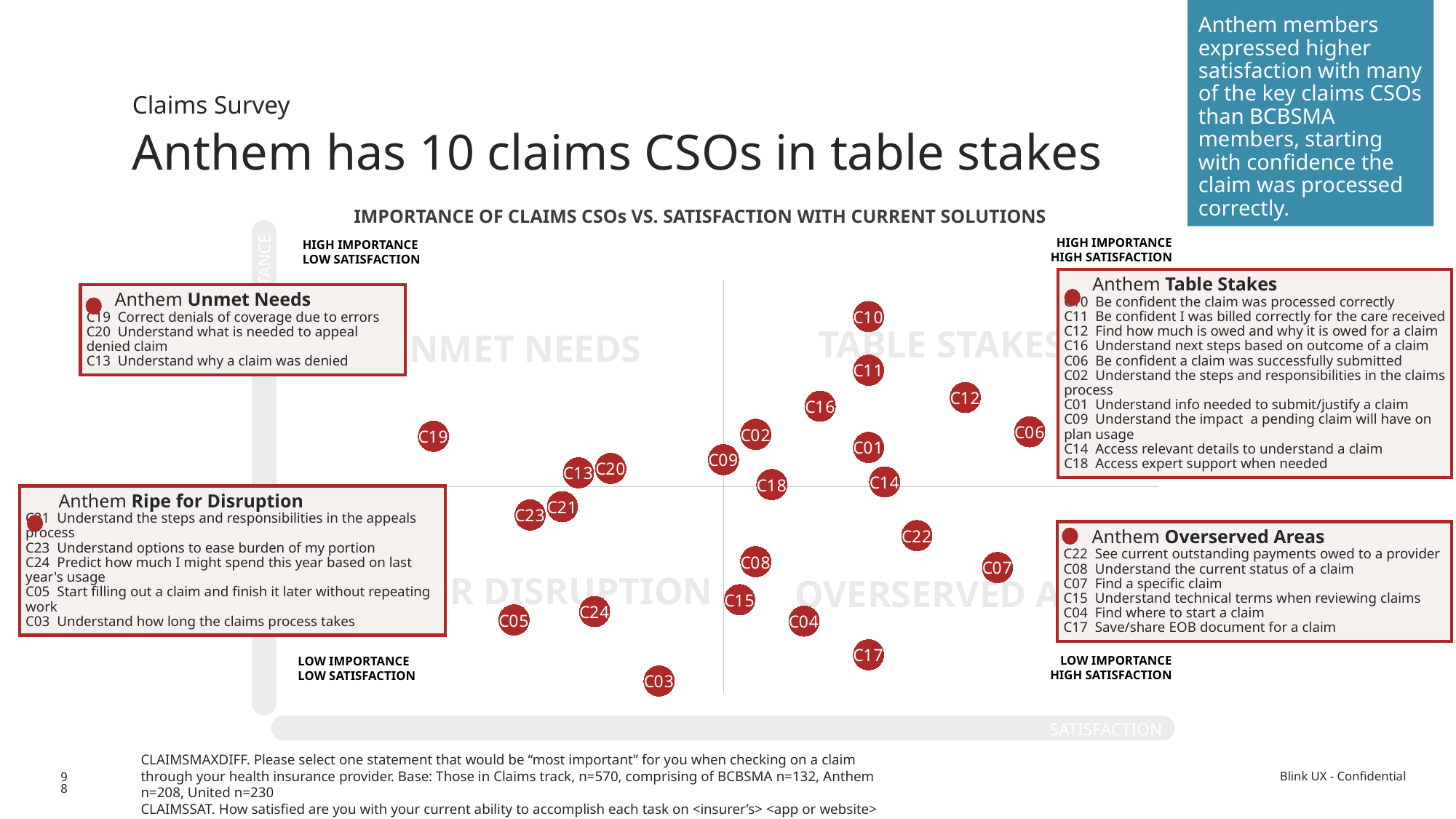
What is the title of the chart? IMPORTANCE OF CLAIMS CSOs VS. SATISFACTION WITH CURRENT SOLUTIONS What kind of chart is shown on the slide? Scatter chart Which CSO point is plotted lowest on the importance axis? C03 Which CSO point is plotted furthest left on the satisfaction axis? C19 How many CSO points are plotted on the chart? 24 In which quadrant of the chart does C19 fall? Unmet Needs What label is shown on the horizontal axis of the chart? SATISFACTION Which CSO point is plotted highest on the importance axis? C10 Which is plotted further right on the satisfaction axis, C19 or C12? C12 How many CSOs are listed in the Anthem Table Stakes box? 10 Which CSO point is plotted furthest right on the satisfaction axis? C06 Which is plotted higher on the importance axis, C10 or C17? C10